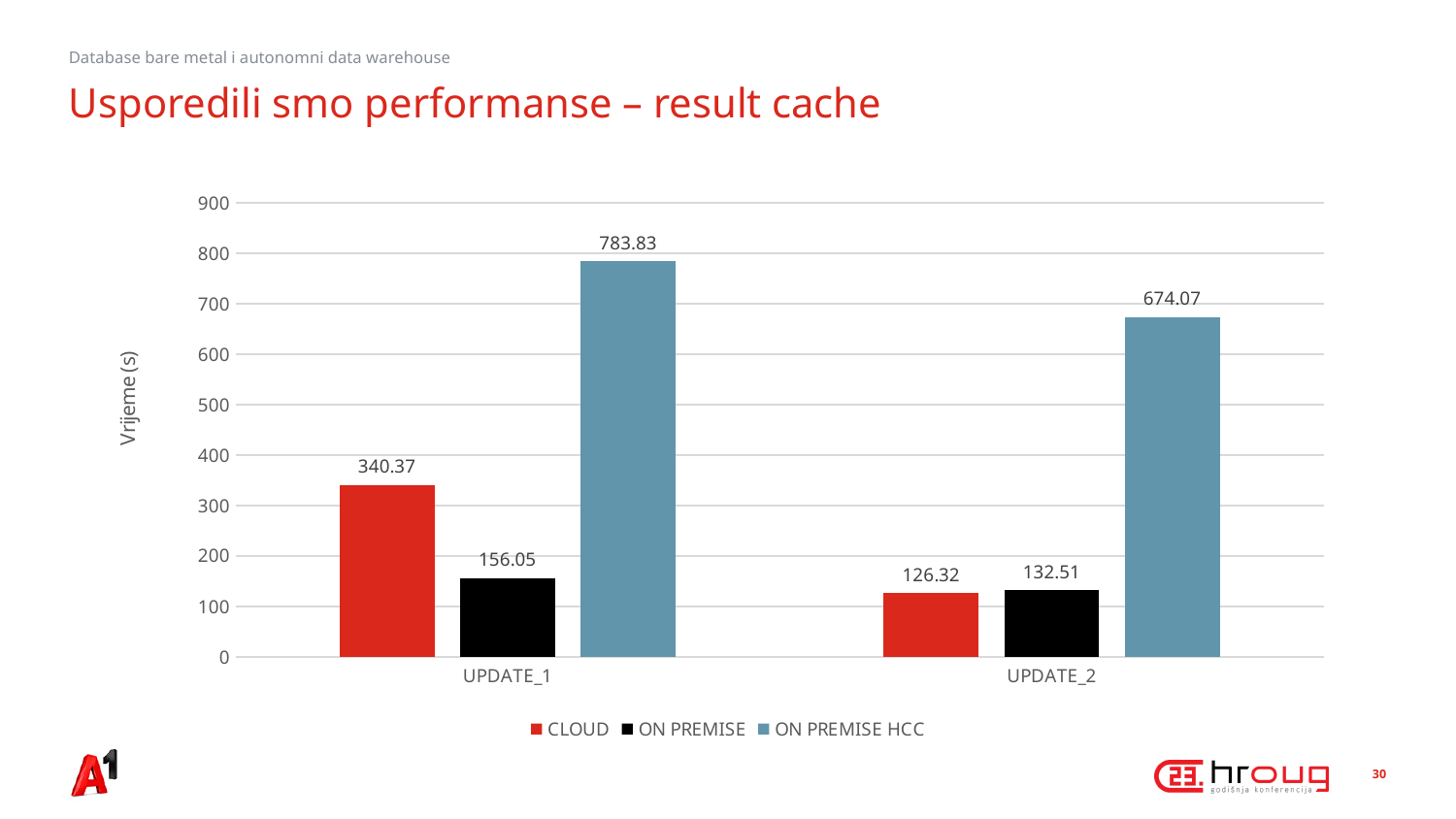
What is the difference between ON PREMISE HCC and CLOUD in UPDATE_1? 443.46 What is the label of the y axis? Vrijeme (s) How many categories are shown on the x axis? 2 What is the value for ON PREMISE HCC in UPDATE_2? 674.07 What is the value for CLOUD in UPDATE_2? 126.32 Which series has the lowest value in UPDATE_2? CLOUD How many series does the legend list? 3 Which series has the highest value in UPDATE_1? ON PREMISE HCC What kind of chart is shown on the slide? Bar chart Which is larger in UPDATE_2: ON PREMISE or CLOUD? ON PREMISE What is the value for ON PREMISE in UPDATE_1? 156.05 What is the value for CLOUD in UPDATE_1? 340.37